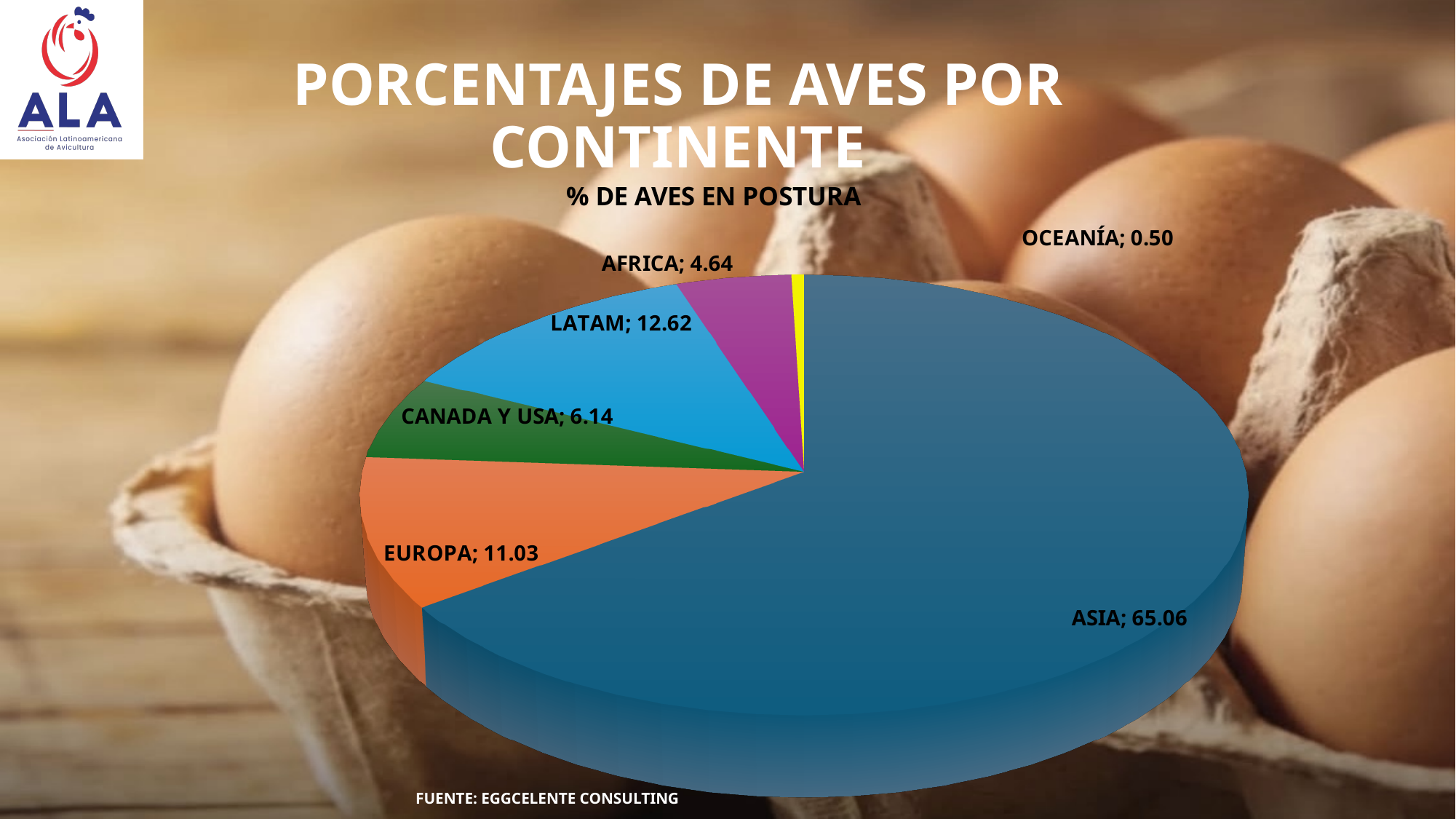
What is the value shown for CANADA Y USA in the pie chart? 6.14 What is the value shown for LATAM in the pie chart? 12.62 How many continents or regions are shown in the pie chart? 6 What is the value shown for OCEANÍA in the pie chart? 0.50 What is the difference between the values for LATAM and EUROPA? 1.59 What is the difference between the values for ASIA and EUROPA? 54.03 What is the title printed directly above the pie chart? % DE AVES EN POSTURA Which continent has the largest slice of the pie chart? ASIA Which continent has the smallest slice of the pie chart? OCEANÍA Which is larger, the value for EUROPA or the value for CANADA Y USA? EUROPA What is the value shown for ASIA in the pie chart? 65.06 What kind of chart is shown on the slide? Pie chart